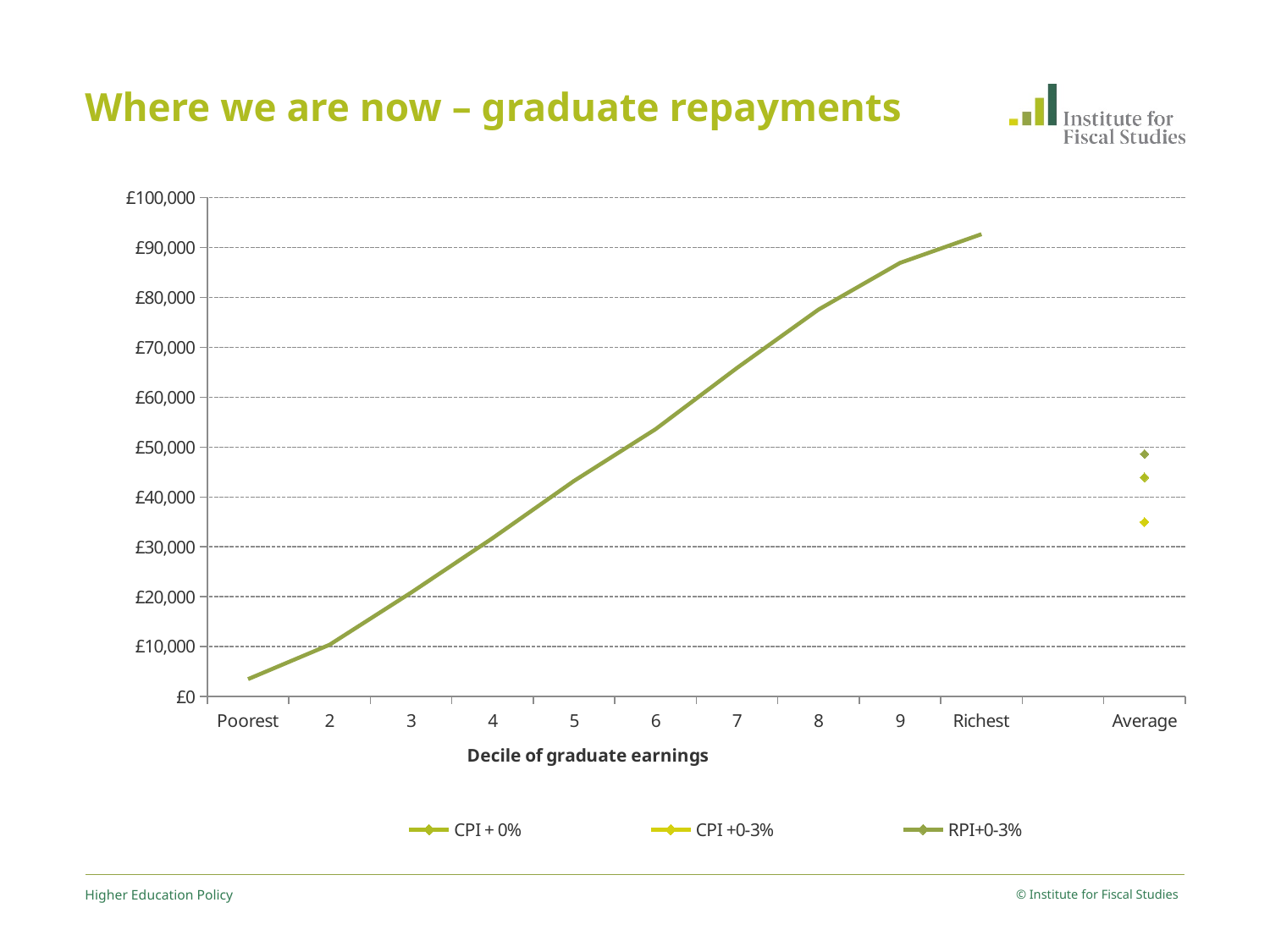
Which decile has the highest repayment value? Richest How many categories are labelled on the x axis? 11 What is the title of the chart? Where we are now – graduate repayments Do graduate repayments rise or fall as the decile of graduate earnings increases from Poorest to Richest? rise Which is larger, the value for decile 9 or the value for decile 4? decile 9 What is the label of the x axis? Decile of graduate earnings Is the value for the Richest decile greater or less than £90,000? greater What kind of chart is shown on the slide? line chart How many series does the legend list? 3 Is the value for the Poorest decile greater or less than £10,000? less Which decile has the lowest repayment value? Poorest Is the value for decile 8 greater or less than £70,000? greater